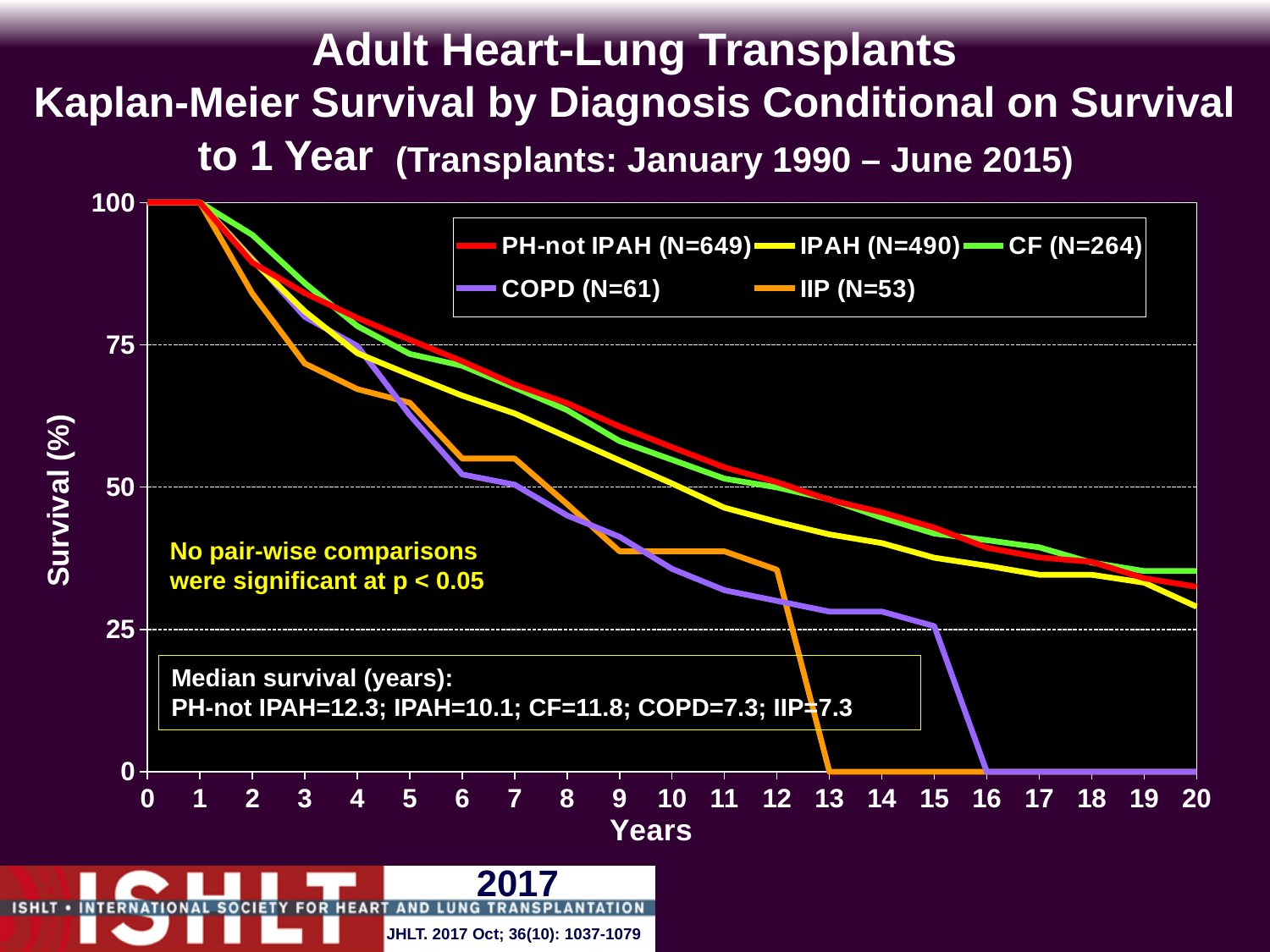
What kind of chart is shown on the slide? line chart Do the survival curves rise or fall as years increase? fall What is the median survival in years for CF according to the text box? 11.8 Which diagnosis group has the smallest N in the legend? IIP (N=53) What is the difference in median survival (years) between PH-not IPAH and IPAH? 2.2 How many series does the legend list? 5 At 15 years, which curve is higher, COPD or IIP? COPD What is the label of the y axis? Survival (%) What is the N for the IPAH group shown in the legend? 490 Is the survival value for COPD at 10 years greater or less than 50? less Which diagnosis group has the largest N in the legend? PH-not IPAH (N=649) Is the survival value for IPAH at 5 years greater or less than 50? greater